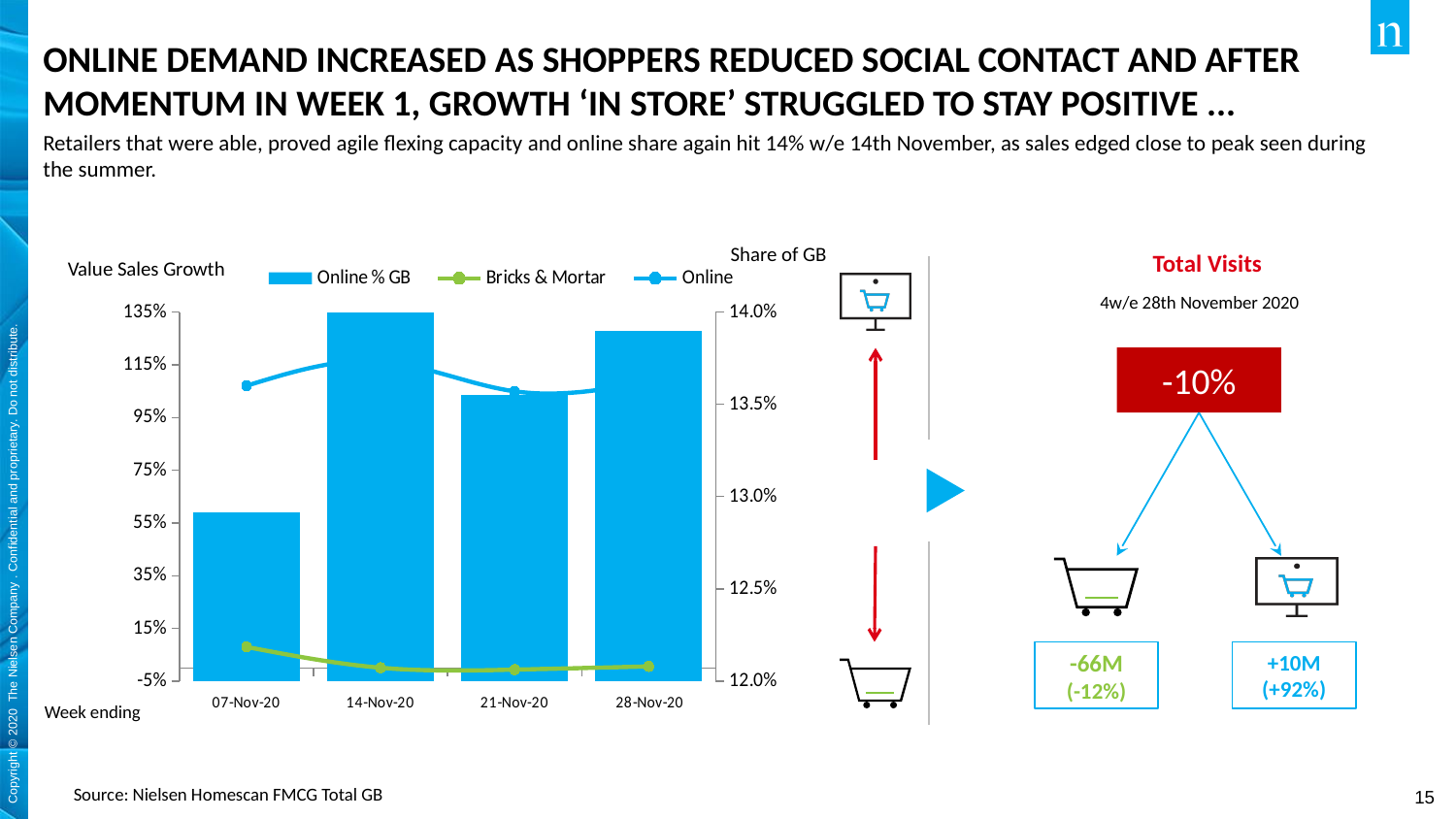
Does the Bricks & Mortar line rise or fall from 07-Nov-20 to 14-Nov-20? fall Is the Online % GB value for 21-Nov-20 greater or less than 95%? less What is the title of the chart's right-hand axis? Share of GB Which week ending has the tallest Online % GB bar? 14-Nov-20 What kind of chart is shown on the slide? A combination bar and line chart Which is larger, the Online % GB bar for 28-Nov-20 or for 21-Nov-20? 28-Nov-20 How many series does the chart's legend list? 3 Which week ending has the shortest Online % GB bar? 07-Nov-20 Which week ending has the highest point on the Bricks & Mortar line? 07-Nov-20 Is the Online % GB value for 07-Nov-20 greater or less than 75%? less Is the Online % GB value for 14-Nov-20 greater or less than 115%? less How many week-ending categories are shown on the x axis of the chart? 4